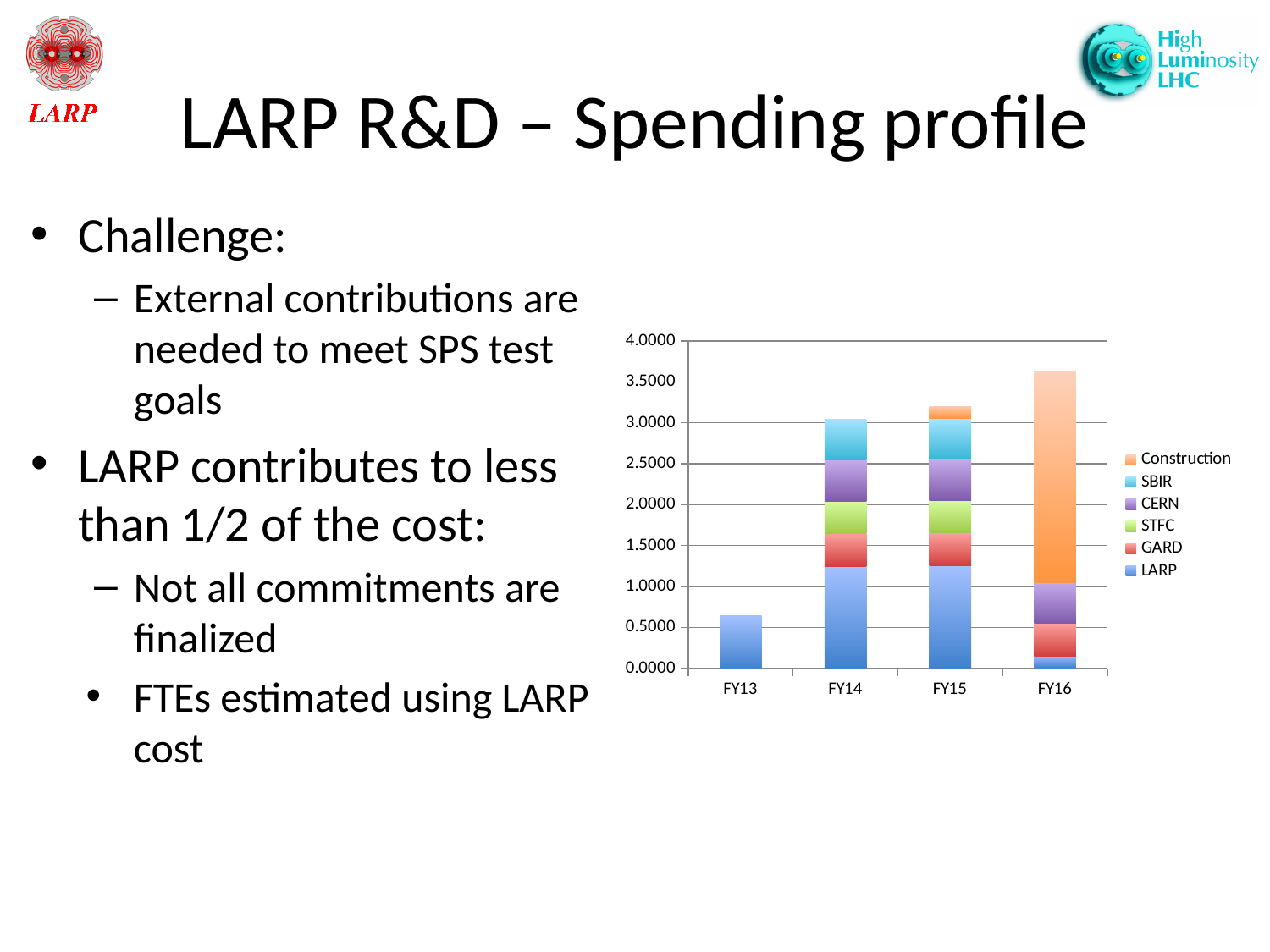
How many series does the chart legend list? 6 Is the total for FY15 greater or less than 3.0000? greater Which fiscal year's bar consists of only the LARP series? FY13 How many fiscal years are shown on the x axis of the chart? 4 Do the total bar heights rise or fall from FY13 to FY16? rise Which fiscal year has the lowest total stacked bar? FY13 Which series is shown in orange in the chart legend? Construction Which fiscal year has the highest total stacked bar? FY16 Is the total for FY13 greater or less than 1.0000? less Which has the larger total bar, FY13 or FY14? FY14 What kind of chart is shown on the slide? stacked bar chart Is the total for FY16 greater or less than 3.5000? greater